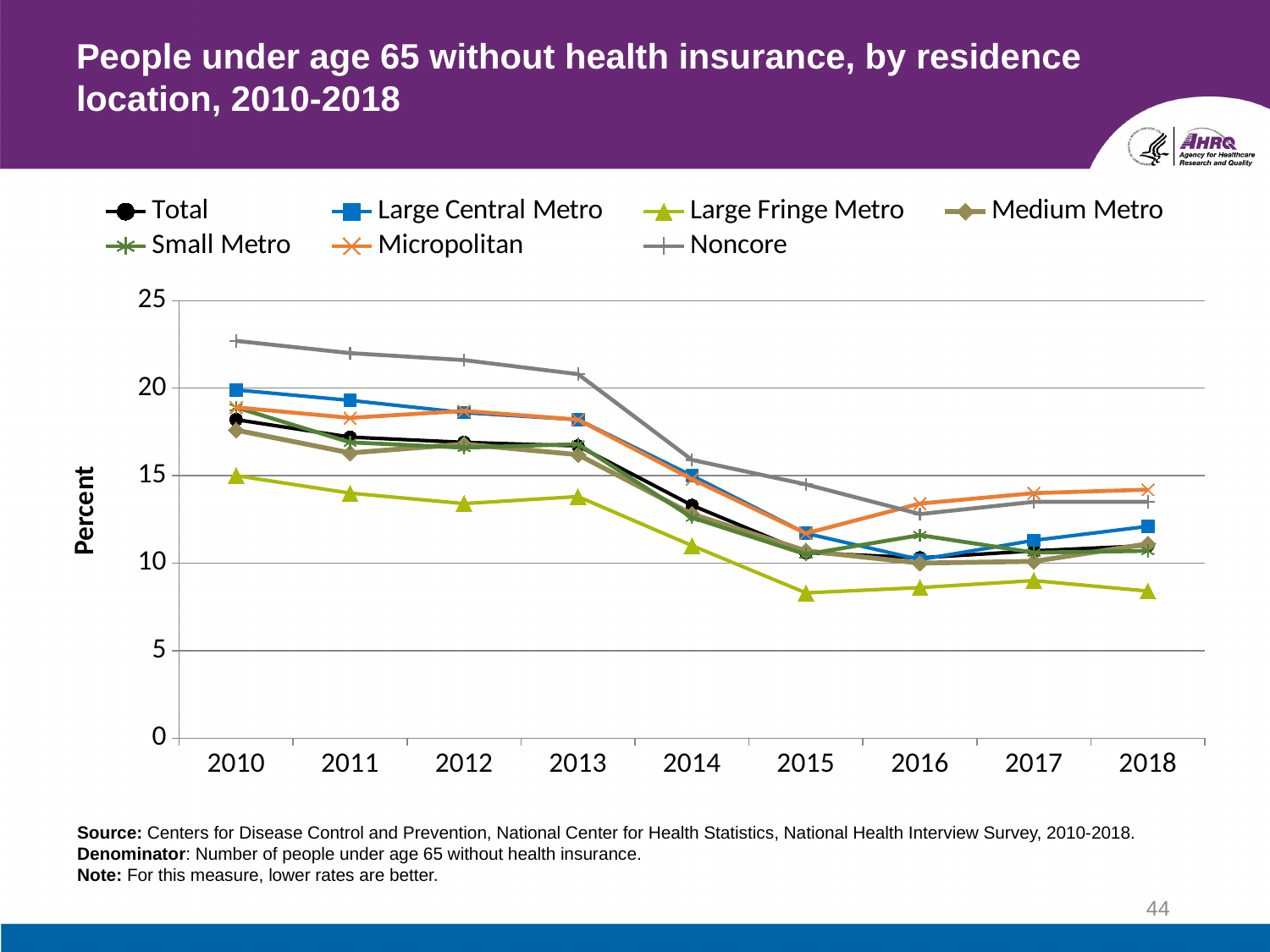
What is the label on the y axis? Percent Which residence location had the highest uninsured percentage in 2010? Noncore What kind of chart is shown on the slide? line chart Did the Noncore percentage rise or fall from 2010 to 2015? fall Is the value for Noncore in 2010 greater or less than 20? greater How many years are plotted along the x axis? 9 In 2013, which is larger: the value for Noncore or the value for Large Fringe Metro? Noncore Is the value for Total in 2018 greater or less than 15? less Which residence location had the lowest uninsured percentage in 2018? Large Fringe Metro Is the value for Large Fringe Metro in 2015 greater or less than 10? less How many series does the legend list? 7 Which residence location had the lowest uninsured percentage in 2010? Large Fringe Metro